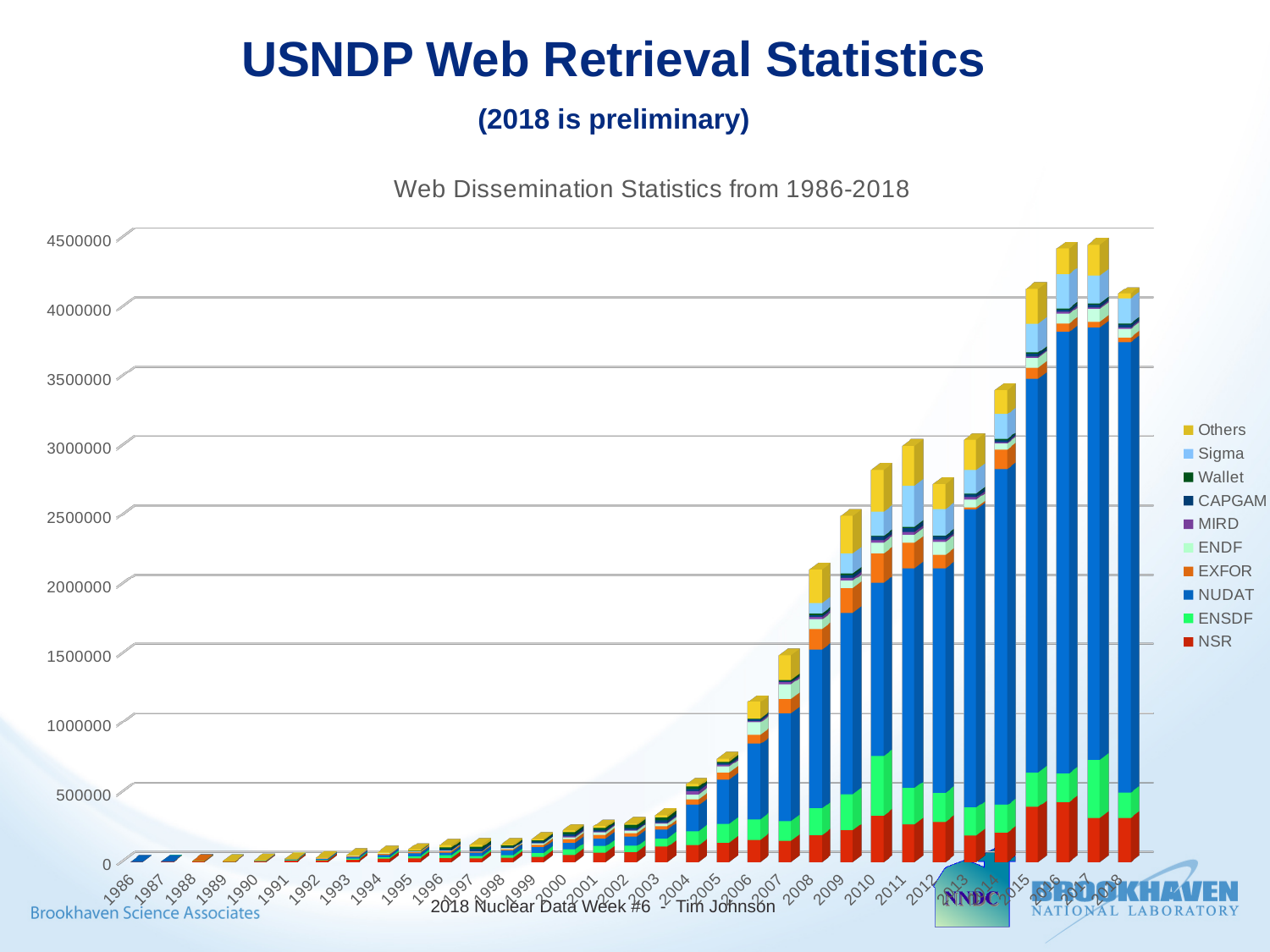
Which year has the larger total, 2016 or 2018? 2016 What is the title of the chart? Web Dissemination Statistics from 1986-2018 Which year has the larger total, 2009 or 2011? 2011 Is the total value for 2017 greater or less than 4000000? greater Is the total value for 2010 greater or less than 2500000? greater Do the total values generally rise or fall from 1986 to 2017? rise What kind of chart is shown on the slide? stacked bar chart How many years are plotted along the x axis? 33 Is the total value for 2012 greater or less than 3000000? less Which series is listed first in the legend? Others How many series does the legend list? 10